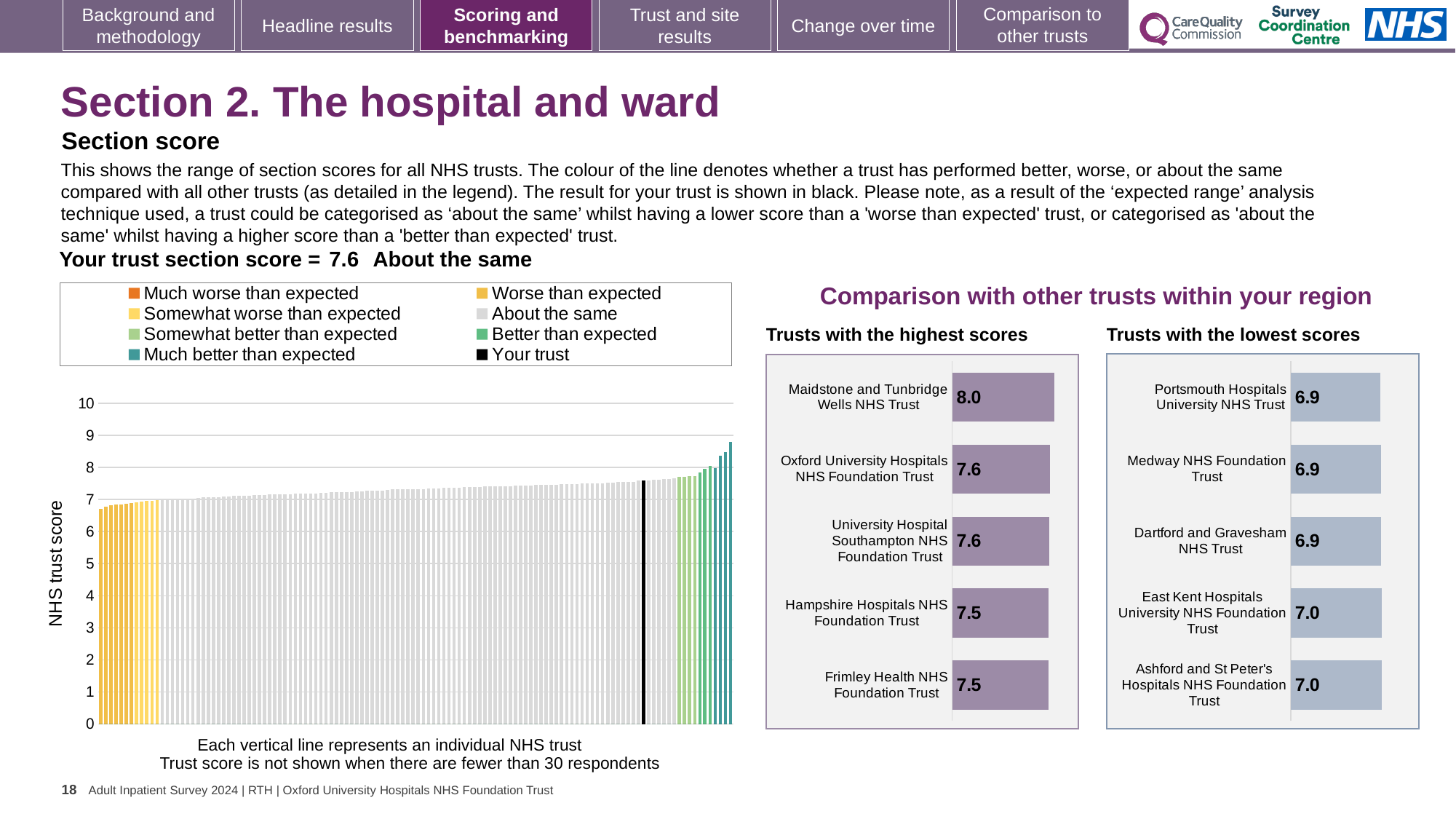
In the 'Trusts with the highest scores' chart, what is the score for Frimley Health NHS Foundation Trust? 7.5 In the 'Trusts with the highest scores' chart, which has the larger score: Maidstone and Tunbridge Wells NHS Trust or Oxford University Hospitals NHS Foundation Trust? Maidstone and Tunbridge Wells NHS Trust In the 'NHS trust score' chart on the left, is the value of the black 'Your trust' bar greater or less than 5? greater How many trusts are shown in the 'Trusts with the lowest scores' chart? 5 In the 'Trusts with the highest scores' chart, what is the difference between the scores of Maidstone and Tunbridge Wells NHS Trust and Hampshire Hospitals NHS Foundation Trust? 0.5 In the 'NHS trust score' chart on the left, do the bar values rise or fall from left to right along the x axis? rise In the 'Trusts with the highest scores' chart, what is the score for Maidstone and Tunbridge Wells NHS Trust? 8.0 How many entries does the legend of the 'NHS trust score' chart on the left list? 8 In the 'Trusts with the lowest scores' chart, what is the score for East Kent Hospitals University NHS Foundation Trust? 7.0 In the 'Trusts with the lowest scores' chart, what is the score for Portsmouth Hospitals University NHS Trust? 6.9 What kind of chart is the large 'NHS trust score' chart on the left of the slide? bar chart In the 'Trusts with the highest scores' chart, which trust has the highest score? Maidstone and Tunbridge Wells NHS Trust